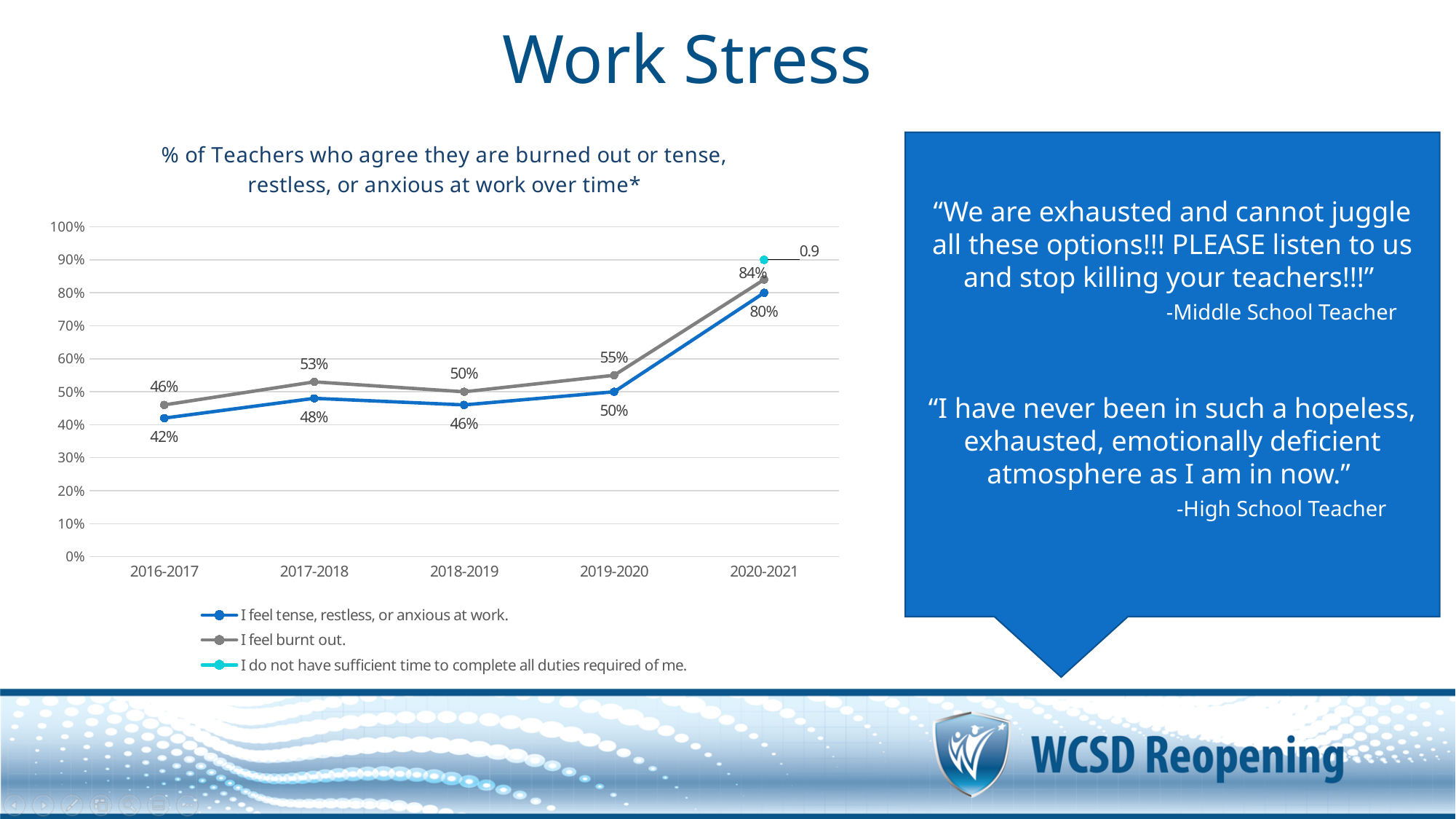
How many school years are shown on the x axis? 5 What percentage of teachers agreed 'I feel burnt out' in 2017-2018? 53% What is the difference between 'I feel burnt out' and 'I feel tense, restless, or anxious at work' in 2019-2020? 5% What type of chart is shown on the slide? line chart Which is larger in 2018-2019: 'I feel burnt out' or 'I feel tense, restless, or anxious at work'? I feel burnt out Does the value for 'I feel tense, restless, or anxious at work' rise or fall from 2019-2020 to 2020-2021? rise What percentage of teachers agreed 'I feel tense, restless, or anxious at work' in 2020-2021? 80% What is the title of the chart? % of Teachers who agree they are burned out or tense, restless, or anxious at work over time* In which school year is the value for 'I feel tense, restless, or anxious at work' lowest? 2016-2017 In which school year is the value for 'I feel burnt out' highest? 2020-2021 What value is labelled for 'I do not have sufficient time to complete all duties required of me' in 2020-2021? 0.9 How many series does the legend list? 3